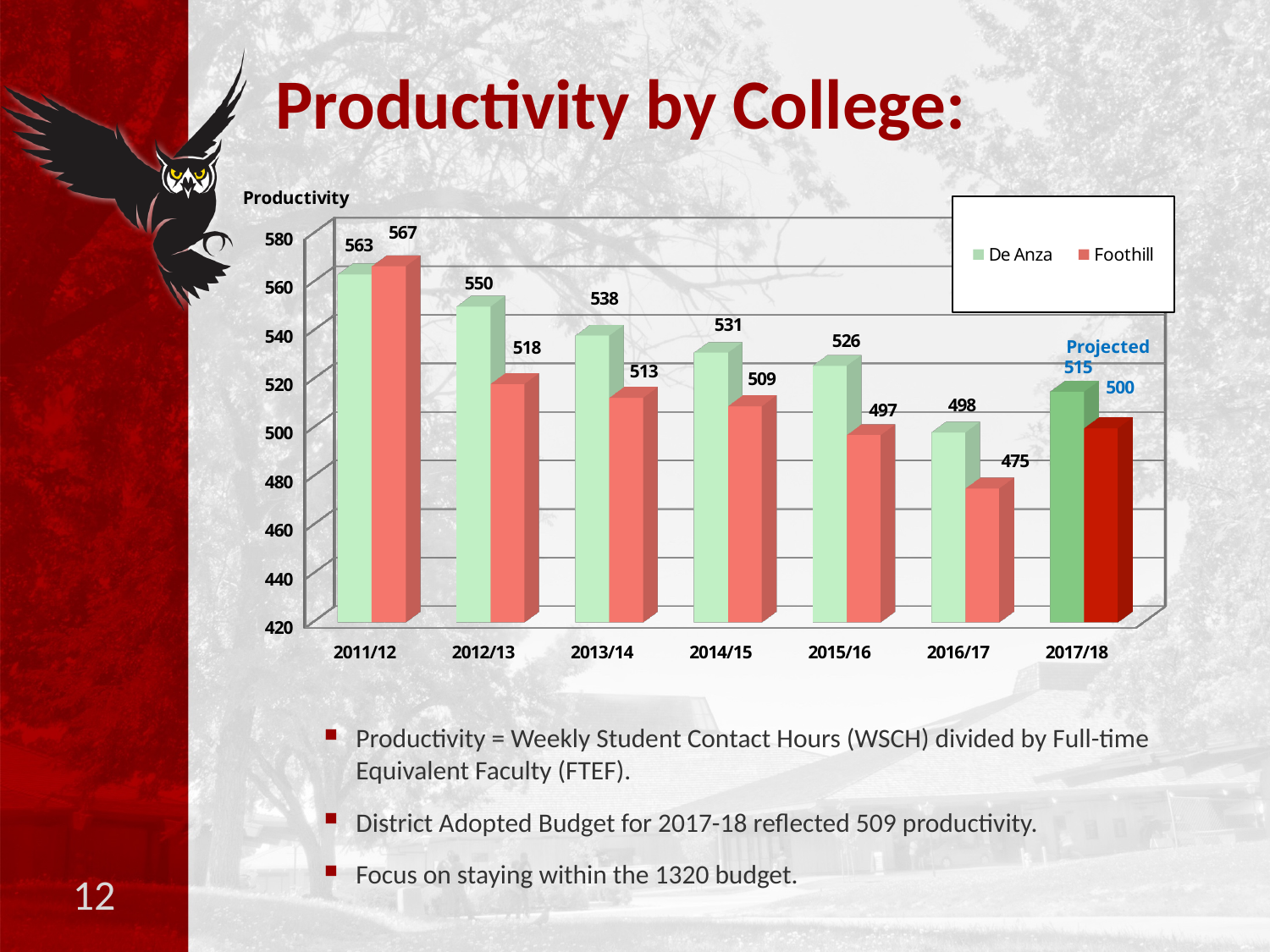
Does the De Anza productivity value rise or fall from 2011/12 to 2016/17? Fall How many series does the legend list? 2 How many years are shown on the x axis of the chart? 7 What is the difference between the De Anza and Foothill productivity values in 2015/16? 29 In which year is the Foothill productivity value highest? 2011/12 Which series is shown in red in the chart? Foothill What is the De Anza productivity value for 2013/14? 538 What kind of chart is shown on the slide? Bar chart Which is larger in 2011/12, the De Anza value or the Foothill value? Foothill What is the projected Foothill productivity value for 2017/18? 500 What is the Foothill productivity value for 2016/17? 475 In which year is the De Anza productivity value lowest? 2016/17